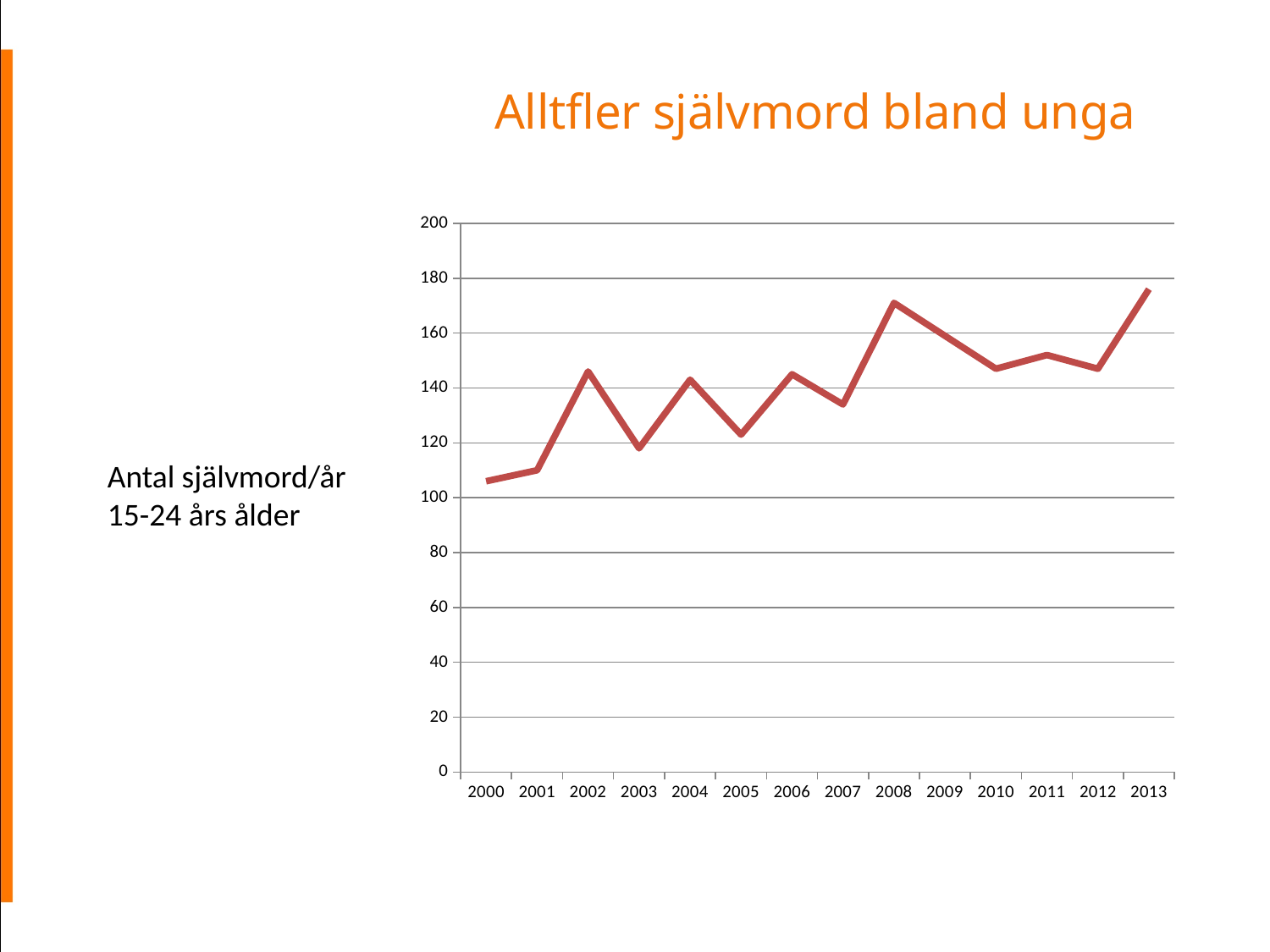
Is the value for 2000 greater or less than 120? less Is the value for 2008 greater or less than 160? greater Is the value for 2005 greater or less than 140? less How many years are plotted along the x axis? 14 Which year has the highest value on the chart? 2013 What is the title of the slide? Alltfler självmord bland unga Which is larger, the value for 2008 or the value for 2003? 2008 Which year has the lowest value on the chart? 2000 What kind of chart is shown on the slide? line chart Overall, do the values rise or fall from 2000 to 2013? rise